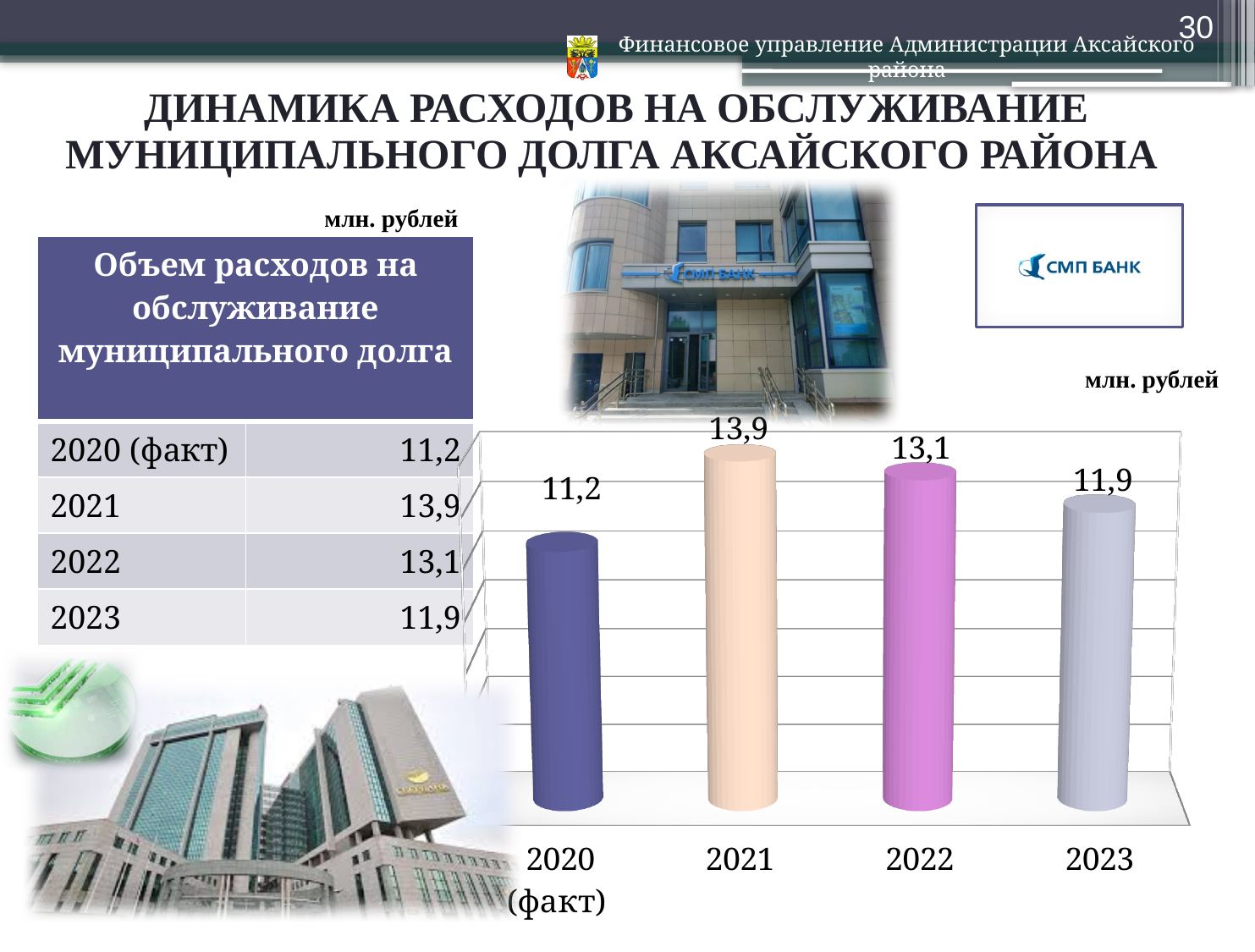
What is the value shown for 2020 (факт) on the chart? 11,2 What kind of chart is shown on the slide? bar chart Do the values rise or fall from 2021 to 2023? fall What is the difference between the values for 2021 and 2020 (факт)? 2,7 Which is larger, the value for 2022 or the value for 2023? 2022 What is the value shown for 2021 on the chart? 13,9 How many bars are plotted on the chart? 4 What is the difference between the values for 2022 and 2023? 1,2 What is the value shown for 2023 on the chart? 11,9 What unit is indicated above the chart? млн. рублей Which year has the lowest value on the chart? 2020 (факт) Which year has the highest value on the chart? 2021